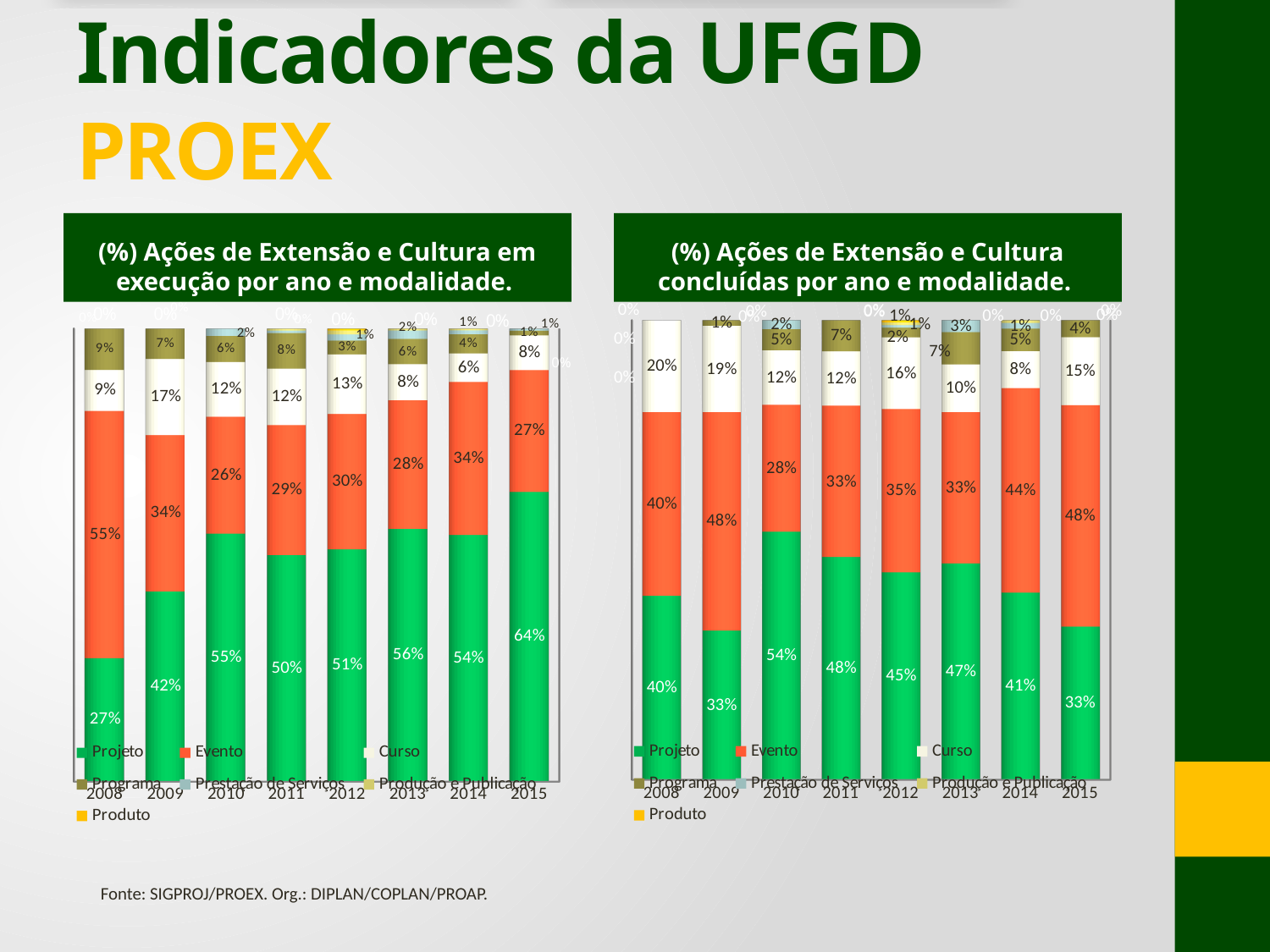
In the left chart (em execução), which year has the highest Projeto value? 2015 How many series does the legend of the right chart (concluídas) list? 7 In the right chart (concluídas), which year has the lowest Curso value? 2014 In the right chart (concluídas), what is the Curso value for 2008? 20% In the right chart (concluídas), what is the Evento value for 2014? 44% In the left chart (em execução), what is the Evento value for 2008? 55% In the right chart (concluídas), which is larger for 2010: Projeto or Evento? Projeto What is the title of the right chart? (%) Ações de Extensão e Cultura concluídas por ano e modalidade. In the left chart (em execução), what is the difference between the Projeto values for 2015 and 2008? 37% In the left chart (em execução), what is the Projeto value for 2015? 64% What kind of chart is the left chart (em execução)? Stacked bar chart How many years are shown on the x axis of the left chart (em execução)? 8